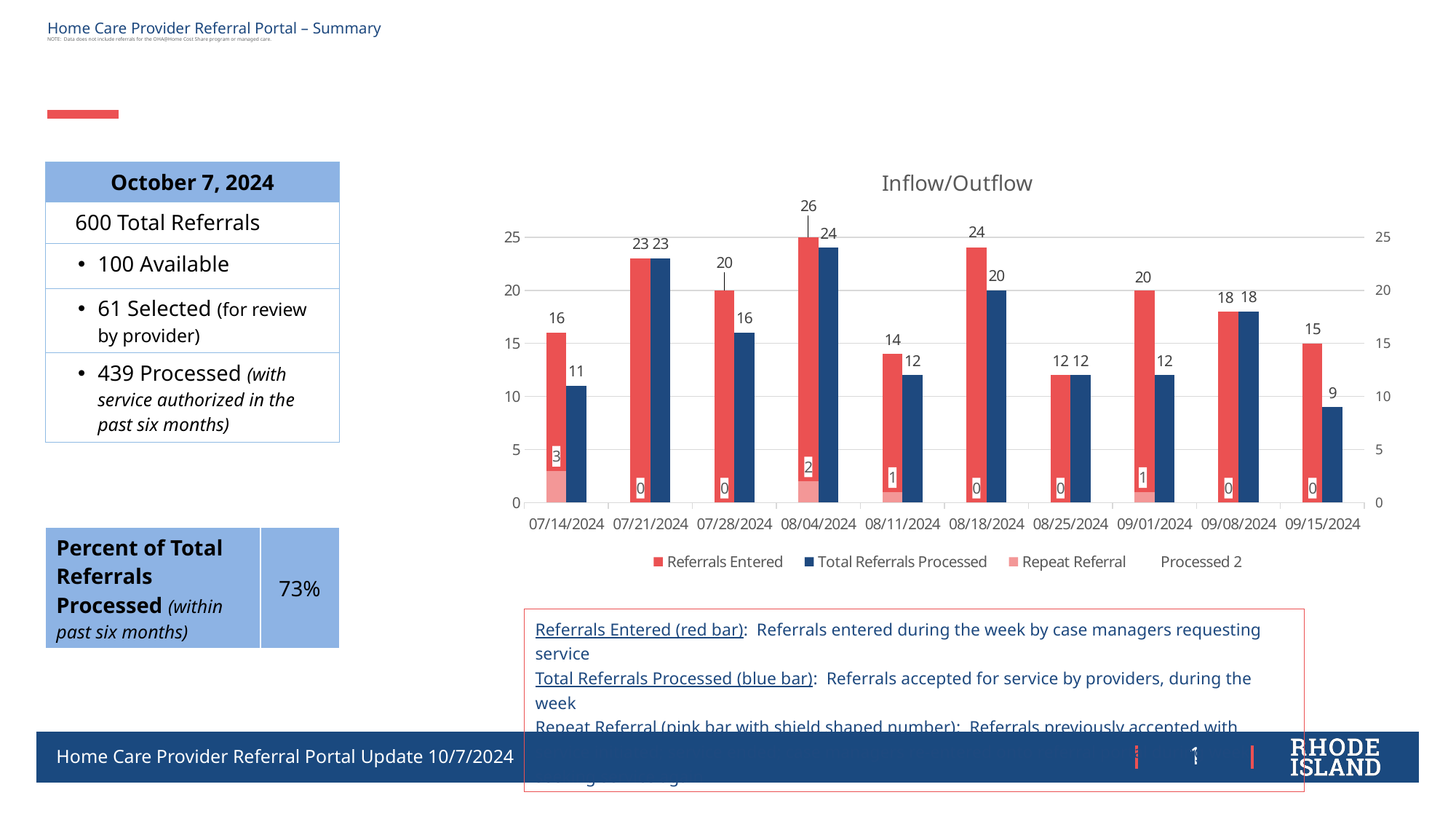
Which date has the highest value for Referrals Entered? 08/04/2024 How many dates are shown on the x axis of the chart? 10 For 07/28/2024, which is larger: Referrals Entered or Total Referrals Processed? Referrals Entered What is the difference between Referrals Entered and Total Referrals Processed for 09/01/2024? 8 How many series does the chart legend list? 4 What is the title of the chart? Inflow/Outflow What is the value of Repeat Referral for 07/14/2024? 3 Which date has the lowest value for Total Referrals Processed? 09/15/2024 What is the value of Total Referrals Processed for 09/15/2024? 9 What type of chart is shown on the slide? bar chart What colour are the Total Referrals Processed bars? blue What is the value of Referrals Entered for 08/04/2024? 26